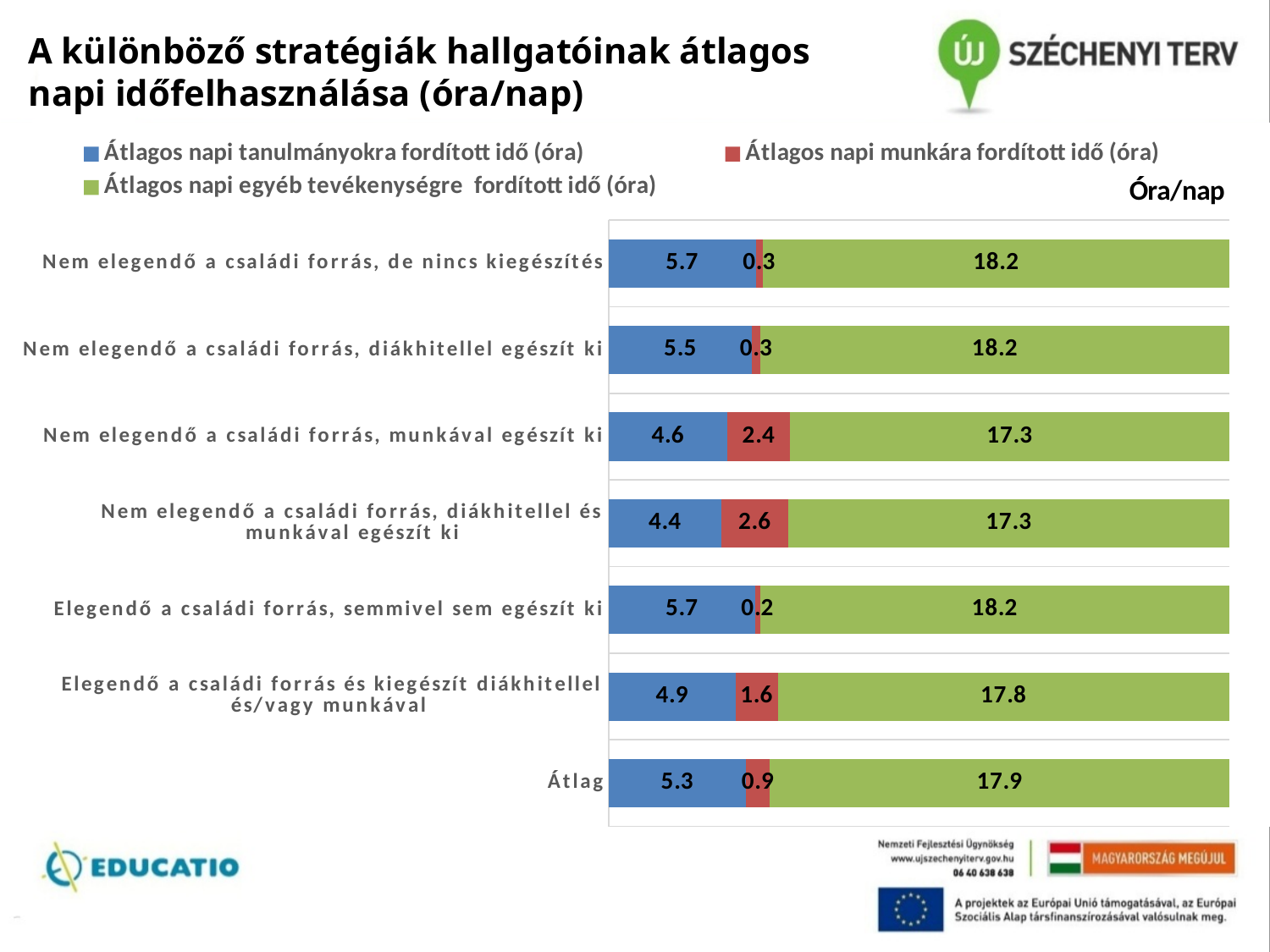
What is the total of the stacked bar for 'Nem elegendő a családi forrás, diákhitellel egészít ki'? 24.0 Which category has the lowest value for 'Átlagos napi tanulmányokra fordított idő (óra)'? Nem elegendő a családi forrás, diákhitellel és munkával egészít ki What is the value of 'Átlagos napi munkára fordított idő (óra)' for 'Elegendő a családi forrás és kiegészít diákhitellel és/vagy munkával'? 1.6 What is the value of 'Átlagos napi tanulmányokra fordított idő (óra)' for 'Nem elegendő a családi forrás, munkával egészít ki'? 4.6 What kind of chart is shown on the slide? stacked bar chart Which is larger: 'Átlagos napi munkára fordított idő (óra)' for 'Nem elegendő a családi forrás, munkával egészít ki' or for 'Elegendő a családi forrás és kiegészít diákhitellel és/vagy munkával'? Nem elegendő a családi forrás, munkával egészít ki How many series does the legend list? 3 Which category has the highest value for 'Átlagos napi munkára fordított idő (óra)'? Nem elegendő a családi forrás, diákhitellel és munkával egészít ki Which category has the lowest value for 'Átlagos napi munkára fordított idő (óra)'? Elegendő a családi forrás, semmivel sem egészít ki What is the value of 'Átlagos napi egyéb tevékenységre fordított idő (óra)' for 'Átlag'? 17.9 What is the difference in 'Átlagos napi tanulmányokra fordított idő (óra)' between 'Nem elegendő a családi forrás, de nincs kiegészítés' and 'Nem elegendő a családi forrás, munkával egészít ki'? 1.1 How many categories are plotted on the chart? 7